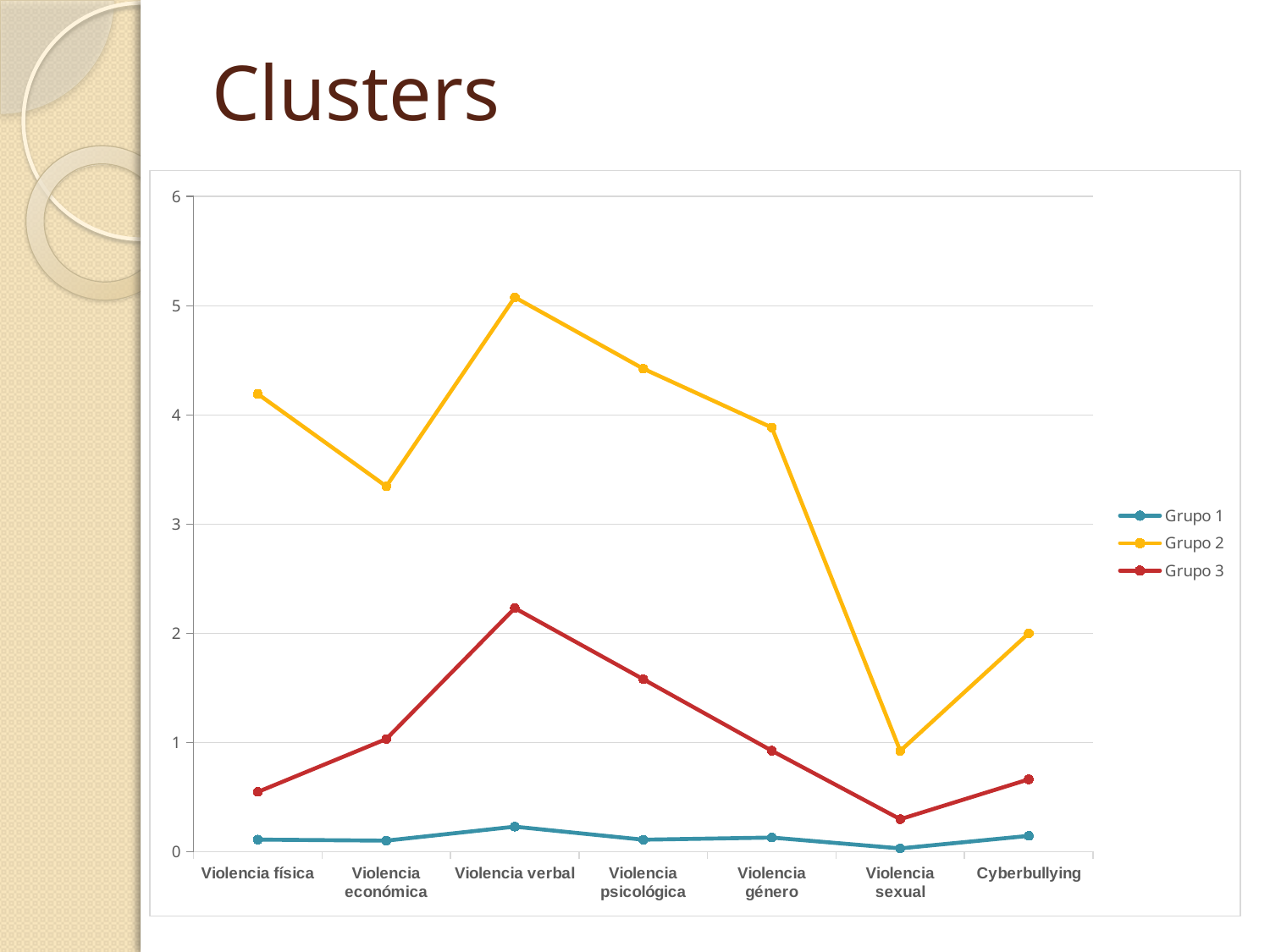
For which category does Grupo 2 have its lowest value? Violencia sexual How many series does the legend list? 3 For which category does Grupo 3 have its lowest value? Violencia sexual For which category does Grupo 2 reach its highest value? Violencia verbal Is the value for Grupo 3 at Violencia física greater or less than 1? less Which series has the larger value for Violencia física, Grupo 2 or Grupo 3? Grupo 2 What kind of chart is shown on the slide? line chart Is the value for Grupo 3 at Violencia verbal greater or less than 2? greater Does the Grupo 2 line rise or fall from Violencia verbal to Violencia sexual? falls How many categories are shown along the x axis? 7 Is the value for Grupo 2 at Violencia económica greater or less than 3? greater For which category does Grupo 3 reach its highest value? Violencia verbal